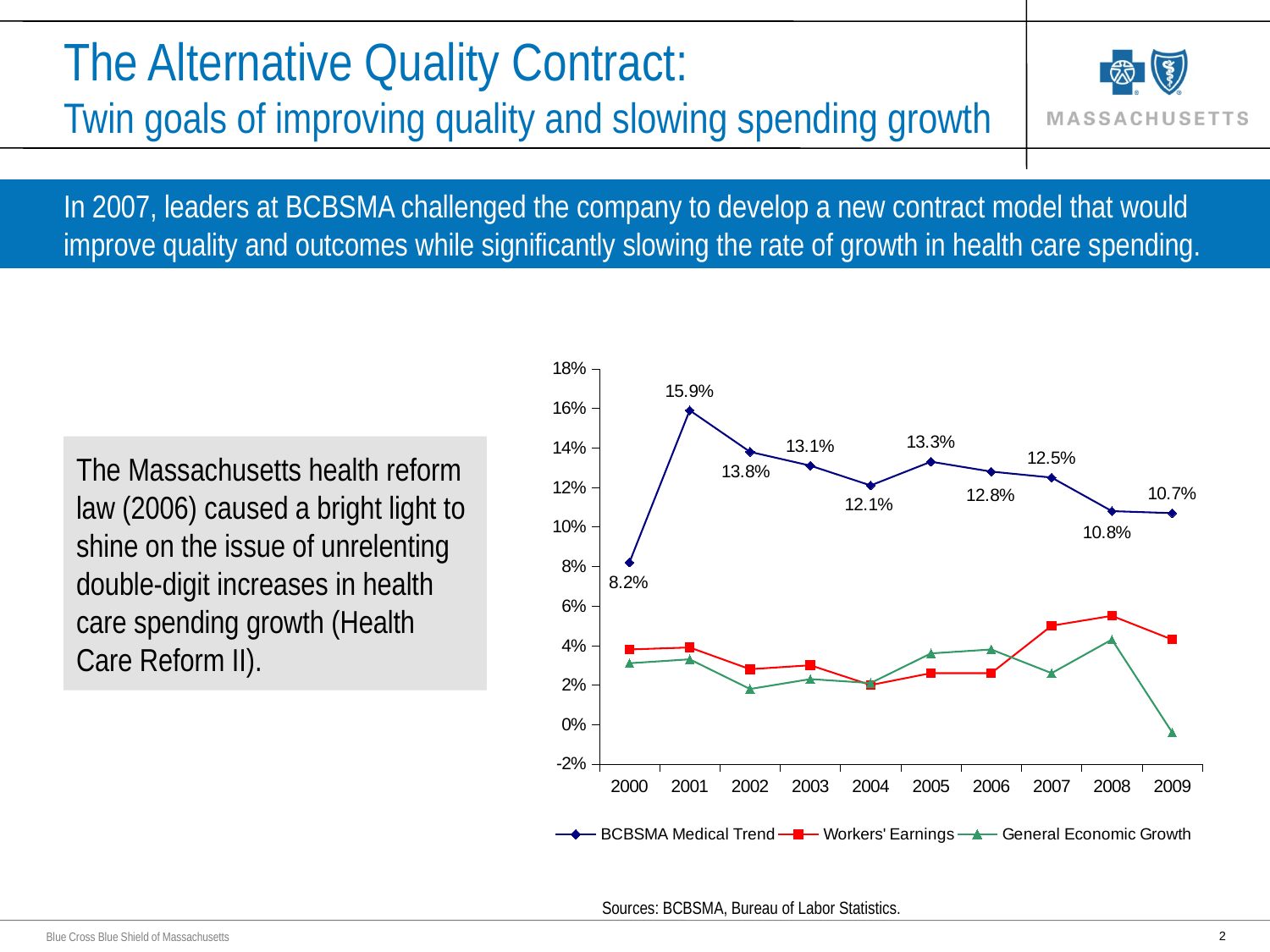
Which was larger, the BCBSMA Medical Trend in 2005 or in 2006? 2005 Is the value for Workers' Earnings in 2008 greater or less than 4%? greater What is the difference between the BCBSMA Medical Trend in 2001 and in 2009? 5.2% What was the BCBSMA Medical Trend value in 2000? 8.2% In which year was the BCBSMA Medical Trend highest? 2001 Is the value for General Economic Growth in 2009 greater or less than 0%? less In which year was the BCBSMA Medical Trend lowest? 2000 What was the BCBSMA Medical Trend value in 2001? 15.9% What kind of chart is shown on the slide? Line chart How many years are shown on the x axis of the chart? 10 What was the BCBSMA Medical Trend value in 2009? 10.7% How many series does the chart's legend list? 3